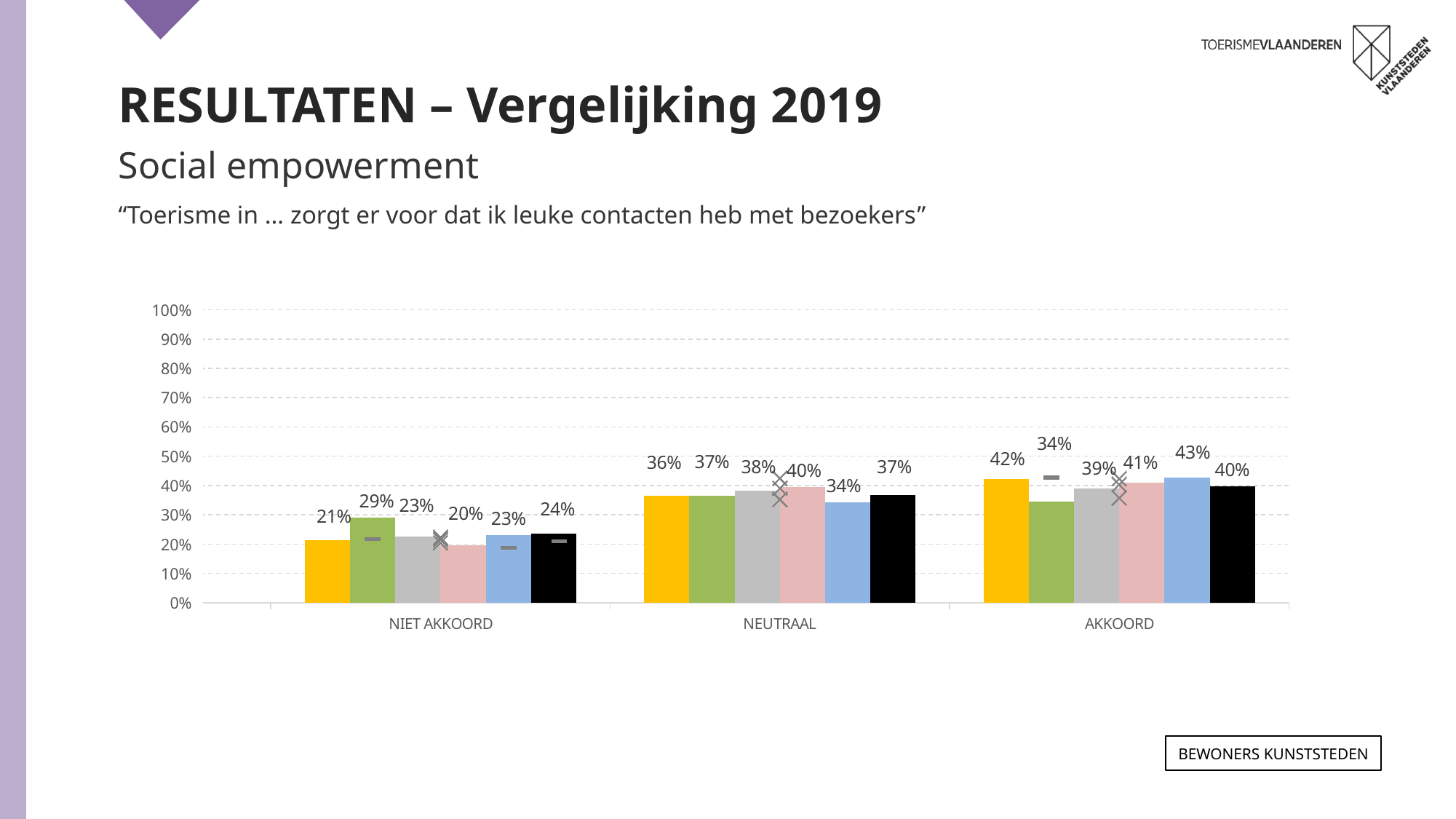
Which bar has the highest value in the NIET AKKOORD category? The green bar (29%) How many bars are plotted in each category of the chart? 6 What are the three category labels on the x axis of the chart? NIET AKKOORD, NEUTRAAL, AKKOORD What is the value of the black bar in the AKKOORD category? 40% How many categories are shown on the x axis of the chart? 3 What is the value of the pink bar in the NEUTRAAL category? 40% What kind of chart is shown on the slide? Bar chart What is the value of the yellow bar in the NIET AKKOORD category? 21% What is the difference between the blue bar in AKKOORD (43%) and the blue bar in NIET AKKOORD (23%)? 20 percentage points Which bar has the lowest value in the AKKOORD category? The green bar (34%) Is the value of the grey bar in the NEUTRAAL category greater or less than 50%? less Which is larger: the yellow bar in NEUTRAAL or the yellow bar in AKKOORD? The yellow bar in AKKOORD (42%)